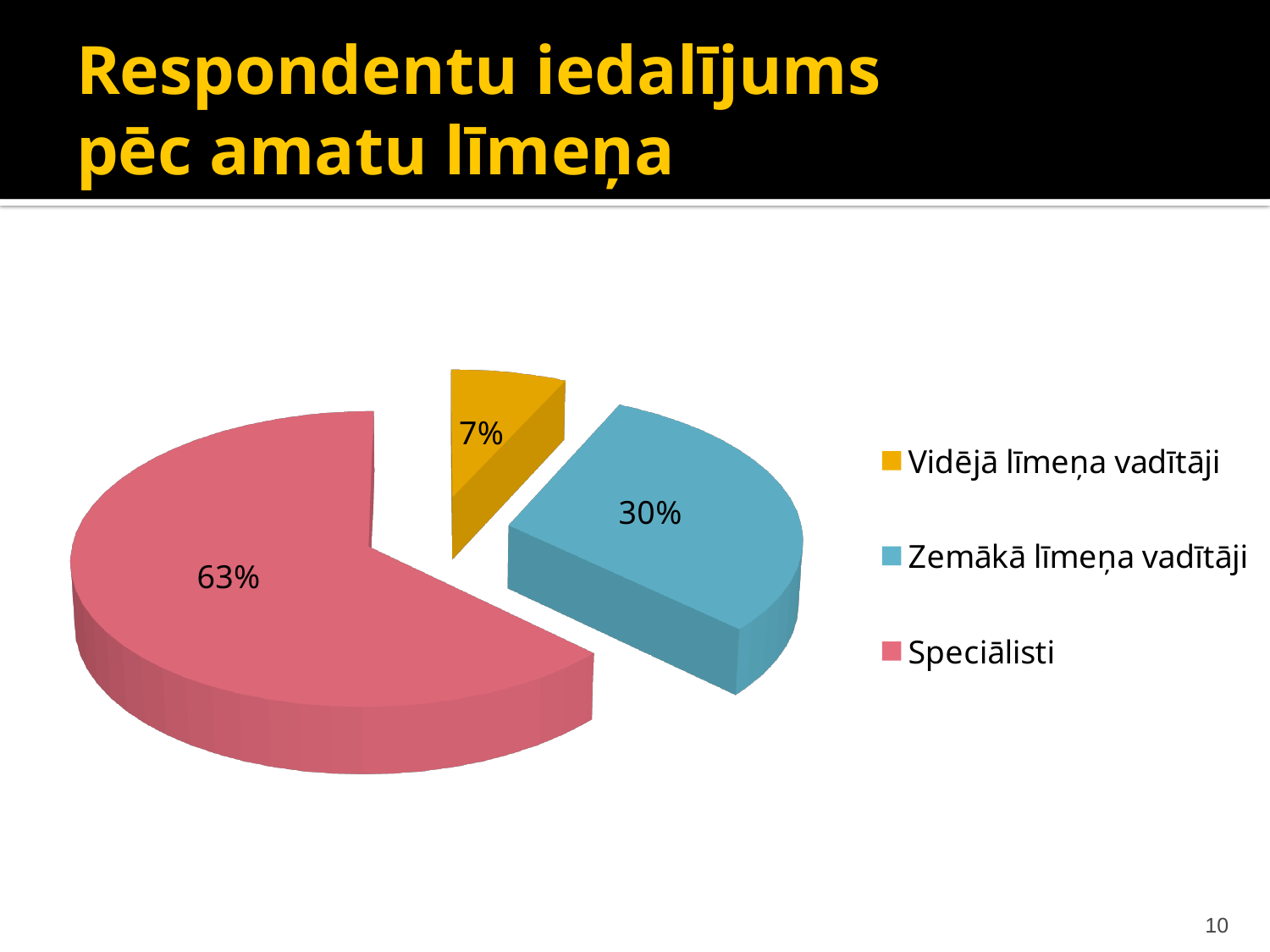
How many categories does the pie chart show? 3 What is the title of the slide? Respondentu iedalījums pēc amatu līmeņa What share of respondents are Zemākā līmeņa vadītāji? 30% Which category has the largest share of respondents? Speciālisti What is the difference in percentage points between Speciālisti and Zemākā līmeņa vadītāji? 33 What share of respondents are Speciālisti? 63% Which is larger: the share of Zemākā līmeņa vadītāji or Vidējā līmeņa vadītāji? Zemākā līmeņa vadītāji What colour is the slice for Speciālisti? Red (pink) Which category has the smallest share of respondents? Vidējā līmeņa vadītāji What share of respondents are Vidējā līmeņa vadītāji? 7% What kind of chart is shown on the slide? Pie chart What is the difference in percentage points between Zemākā līmeņa vadītāji and Vidējā līmeņa vadītāji? 23